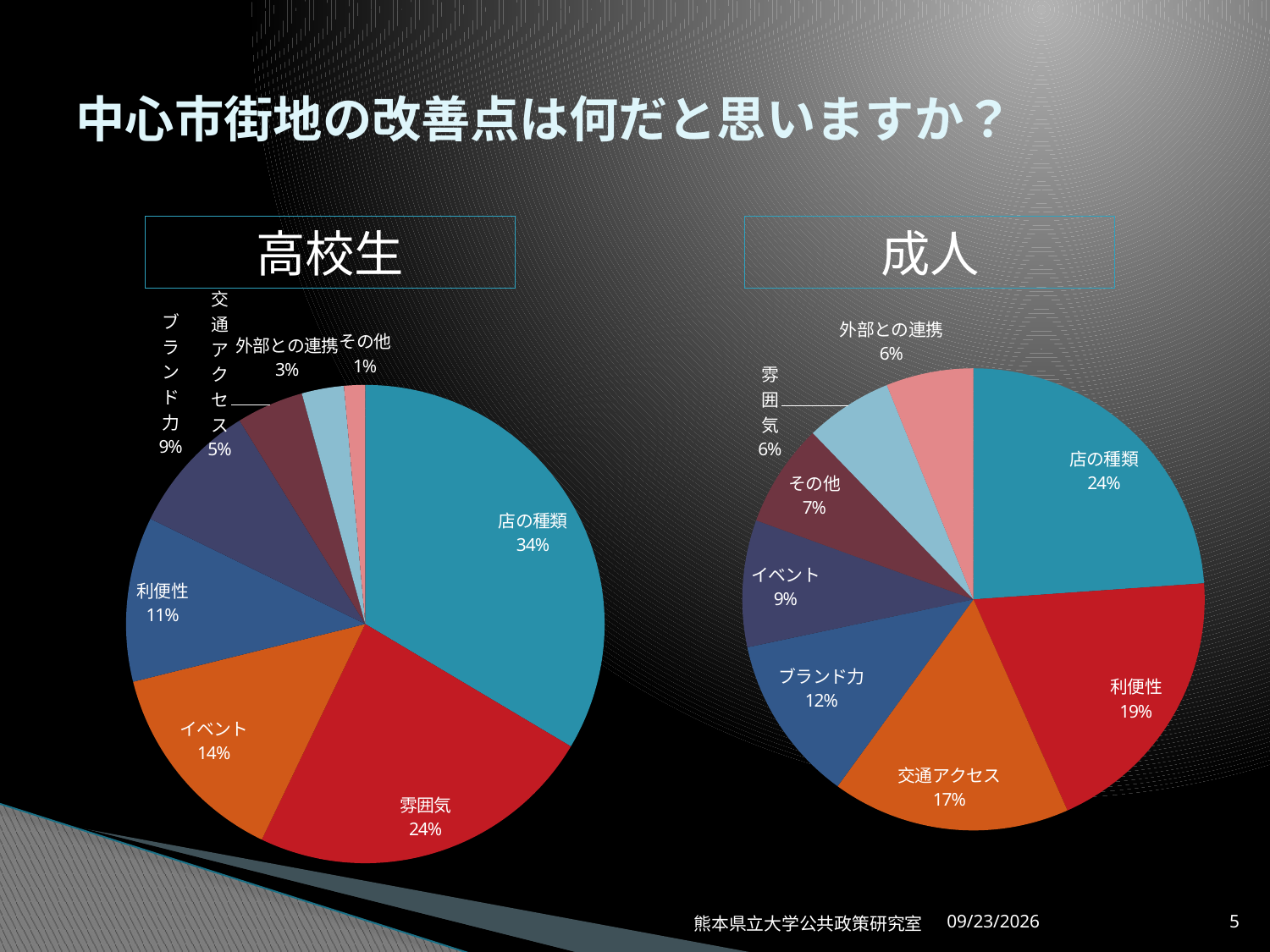
In the 成人 pie chart, which is larger, the share for ブランド力 or the share for イベント? ブランド力 In the 高校生 pie chart, which category has the smallest share? その他 In the 高校生 pie chart, what is the difference between the shares for イベント and 利便性? 3% In the 高校生 pie chart, which category has the largest share? 店の種類 In the 高校生 pie chart, what share is labelled for 雰囲気? 24% In the 成人 pie chart, what share is labelled for 利便性? 19% In the 高校生 pie chart, what share is labelled for 店の種類? 34% In the 成人 pie chart, what share is labelled for 交通アクセス? 17% What is the title of the slide? 中心市街地の改善点は何だと思いますか？ How many categories are shown in the 成人 pie chart? 8 What kind of chart is used for the 高校生 data? Pie chart In the 成人 pie chart, which category has the largest share? 店の種類